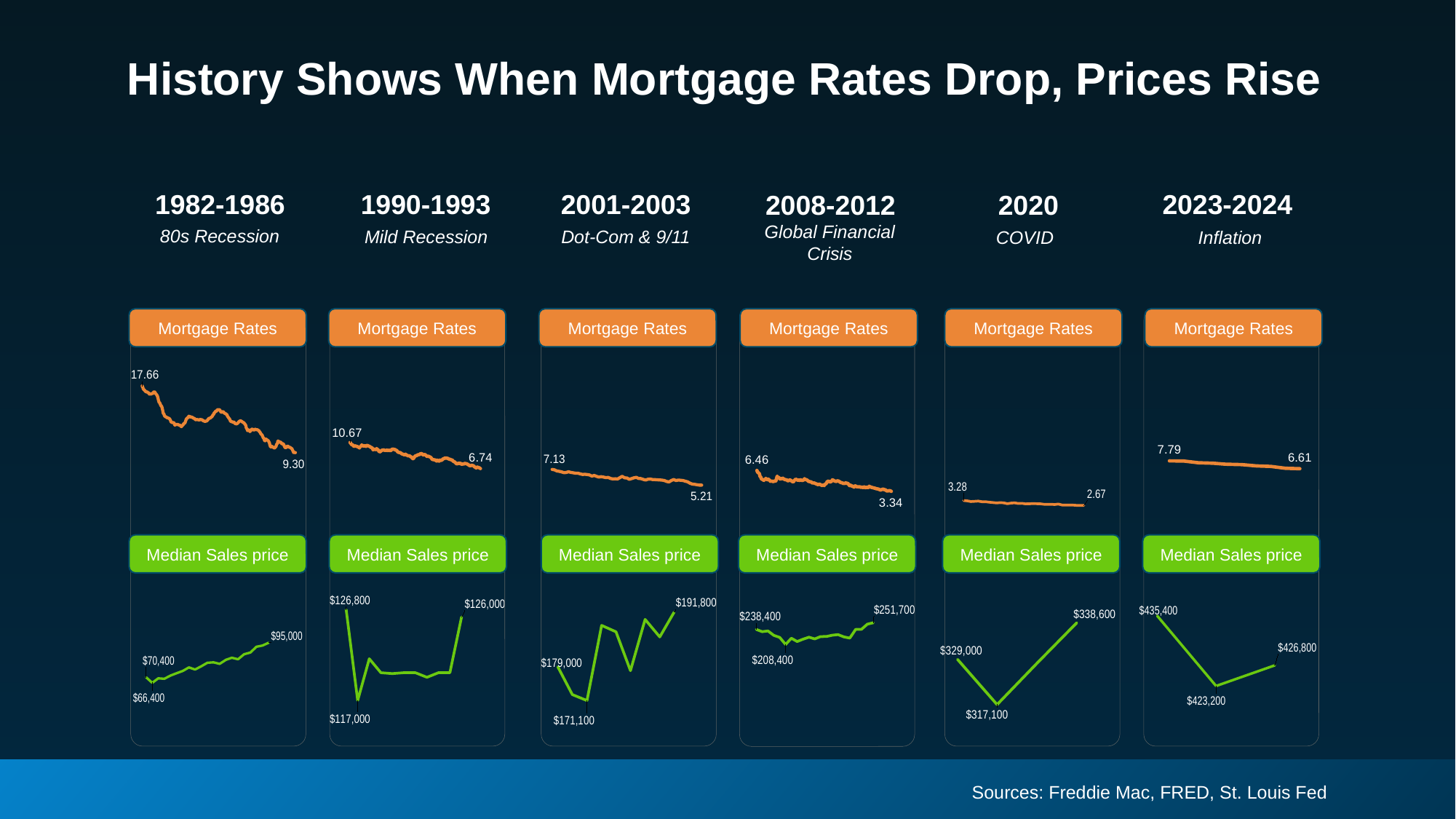
In the 2001-2003 Mortgage Rates chart, do the values rise or fall from left to right? fall In the 1982-1986 Mortgage Rates chart, what is the starting mortgage rate value labeled on the line? 17.66 In the 2008-2012 Median Sales price chart, what is the highest labeled price? $251,700 In the 1982-1986 Mortgage Rates chart, what is the ending mortgage rate value labeled on the line? 9.30 In the 2023-2024 Median Sales price chart, what is the lowest labeled price? $423,200 How many time periods are shown across the slide, each with a Mortgage Rates chart and a Median Sales price chart? 6 What kind of chart is used for the Median Sales price panels on the slide? line chart In the 2020 Mortgage Rates chart, what is the ending value labeled on the line? 2.67 In the 1990-1993 Mortgage Rates chart, what is the difference between the starting value (10.67) and the ending value (6.74)? 3.93 In the 2020 Median Sales price chart, what is the difference between the ending price ($338,600) and the starting price ($329,000)? $9,600 Which is larger: the ending mortgage rate in the 2001-2003 chart or the ending mortgage rate in the 2008-2012 chart? 2001-2003 (5.21) What is the title of the slide? History Shows When Mortgage Rates Drop, Prices Rise